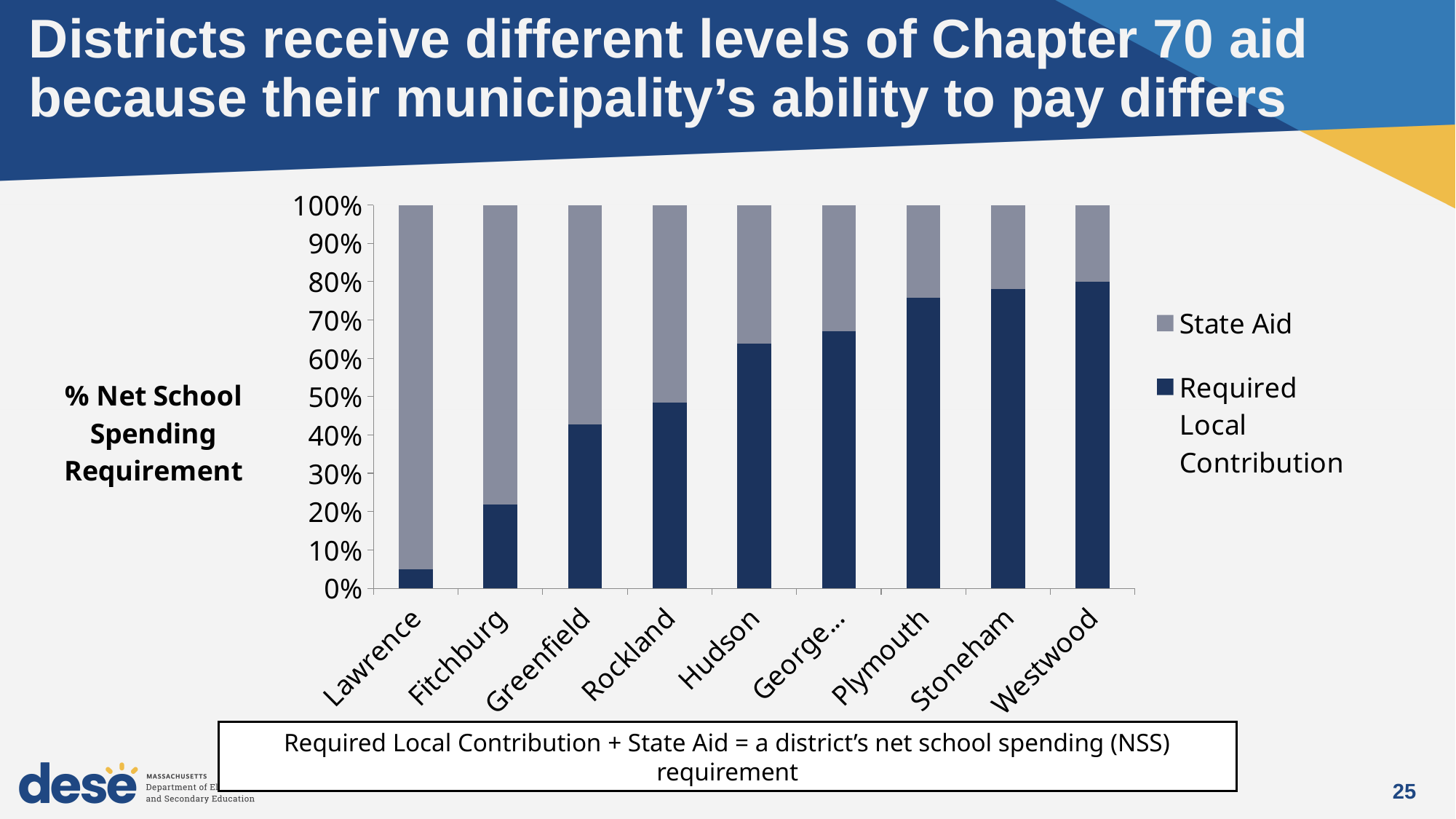
How many districts are shown on the x axis of the chart? 9 Which district receives the largest share of State Aid? Lawrence Does the Required Local Contribution rise or fall moving from Lawrence to Westwood along the x axis? rise What is the total of the stacked bar for Fitchburg? 100% Is the Required Local Contribution for Hudson greater or less than 60%? greater Is the Required Local Contribution for Rockland greater or less than 50%? less What kind of chart is shown on the slide? stacked bar chart Which district has the highest Required Local Contribution? Westwood Which district has the lowest Required Local Contribution? Lawrence How many series does the chart legend list? 2 Is the Required Local Contribution for Lawrence greater or less than 10%? less Which district has a larger Required Local Contribution, Greenfield or Plymouth? Plymouth